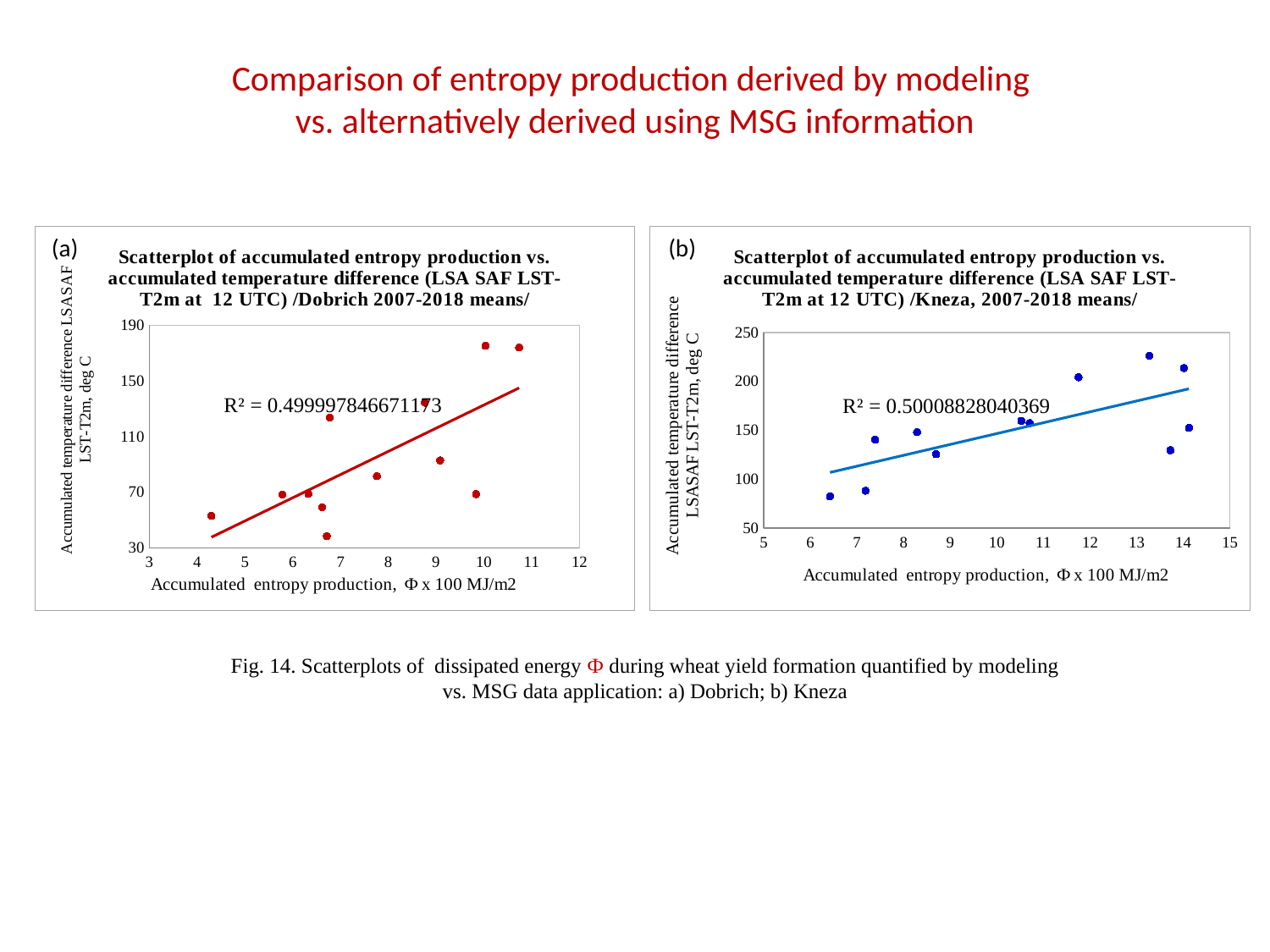
In chart (b) (Kneza), what R² value is printed on the chart? R² = 0.50008828040369 In chart (b) (Kneza), does the fitted trend line rise or fall along the x axis? Rises In chart (a) (Dobrich), is the lowest plotted temperature difference greater or less than 70? less Which chart shows the higher R² value, chart (a) Dobrich or chart (b) Kneza? Chart (b) Kneza In chart (b) (Kneza), is the highest plotted temperature difference greater or less than 200? greater In chart (a) (Dobrich), what R² value is printed on the chart? R² = 0.499997846671173 What is the x-axis label of chart (b) (Kneza)? Accumulated entropy production, Φ x 100 MJ/m2 What colour are the data points in chart (b) (Kneza)? Blue What kind of chart is chart (a), the Dobrich scatterplot? Scatter plot In chart (a) (Dobrich), is the highest plotted temperature difference greater or less than 150? greater In chart (a) (Dobrich), does the fitted trend line rise or fall as accumulated entropy production increases? Rises